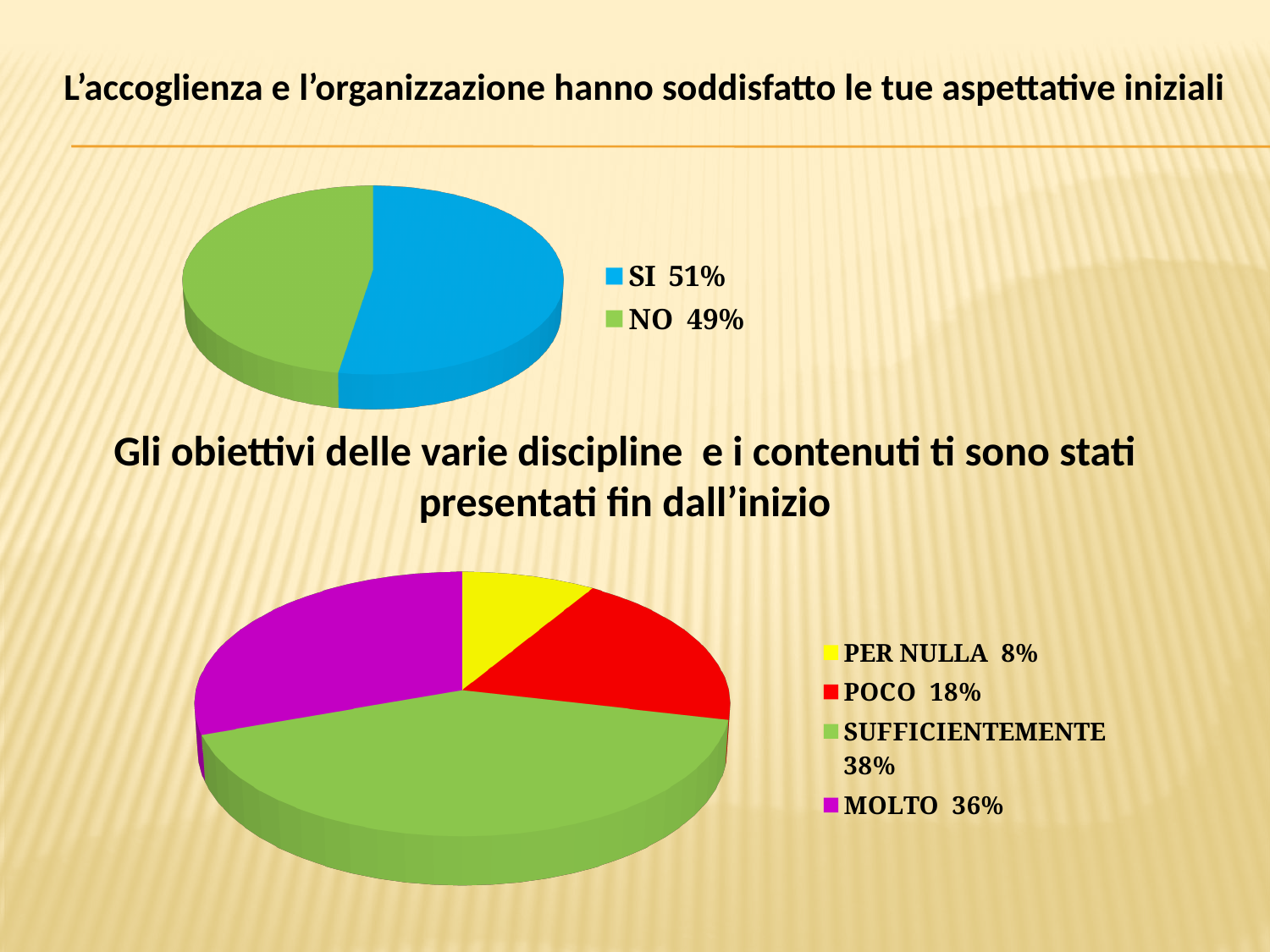
In the top pie chart (L'accoglienza e l'organizzazione...), what percentage is shown for SI? 51% What kind of chart is the top chart on the slide? Pie chart In the bottom pie chart (Gli obiettivi delle varie discipline...), how many categories does the legend list? 4 In the top pie chart (L'accoglienza e l'organizzazione...), what percentage is shown for NO? 49% In the bottom pie chart (Gli obiettivi delle varie discipline...), what percentage is shown for POCO? 18% In the bottom pie chart (Gli obiettivi delle varie discipline...), what is the difference in percentage points between SUFFICIENTEMENTE and PER NULLA? 30 In the bottom pie chart (Gli obiettivi delle varie discipline...), what percentage is shown for MOLTO? 36% In the bottom pie chart (Gli obiettivi delle varie discipline...), which category has the smallest share? PER NULLA In the top pie chart (L'accoglienza e l'organizzazione...), how many categories does the legend list? 2 In the top pie chart (L'accoglienza e l'organizzazione...), what is the difference in percentage points between SI and NO? 2 In the bottom pie chart (Gli obiettivi delle varie discipline...), what colour is the slice for MOLTO? Purple In the bottom pie chart (Gli obiettivi delle varie discipline...), which category has the largest share? SUFFICIENTEMENTE